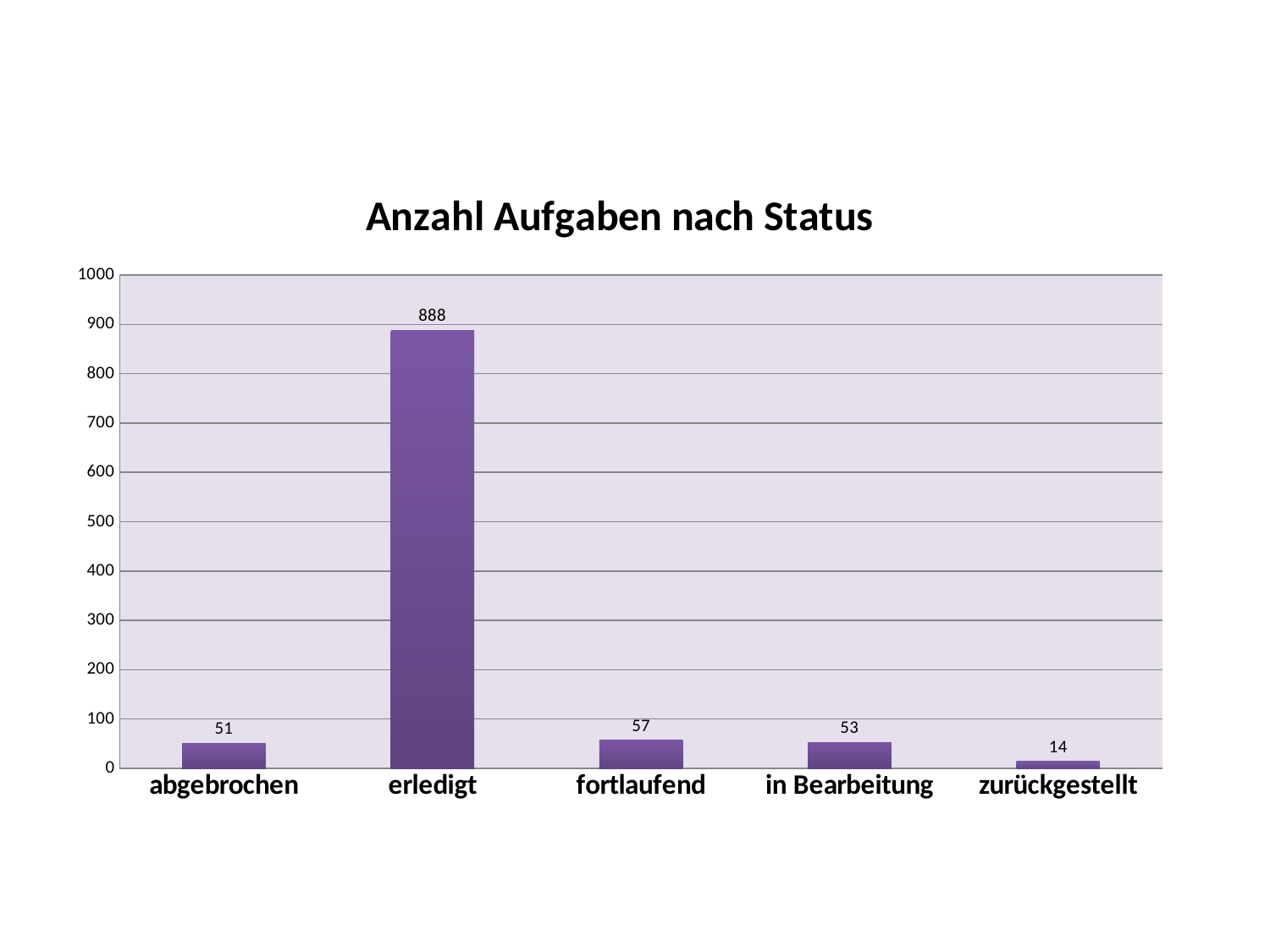
How many status categories are shown on the x axis? 5 What is the difference between the values for erledigt and abgebrochen? 837 What is the value for fortlaufend? 57 What is the value for erledigt? 888 Which status has the lowest number of tasks? zurückgestellt Which status has the highest number of tasks? erledigt What is the title of the chart? Anzahl Aufgaben nach Status What is the value for zurückgestellt? 14 What is the value for in Bearbeitung? 53 Which is larger, the value for abgebrochen or the value for zurückgestellt? abgebrochen Is the value for erledigt greater or less than 800? greater What is the difference between the values for fortlaufend and zurückgestellt? 43